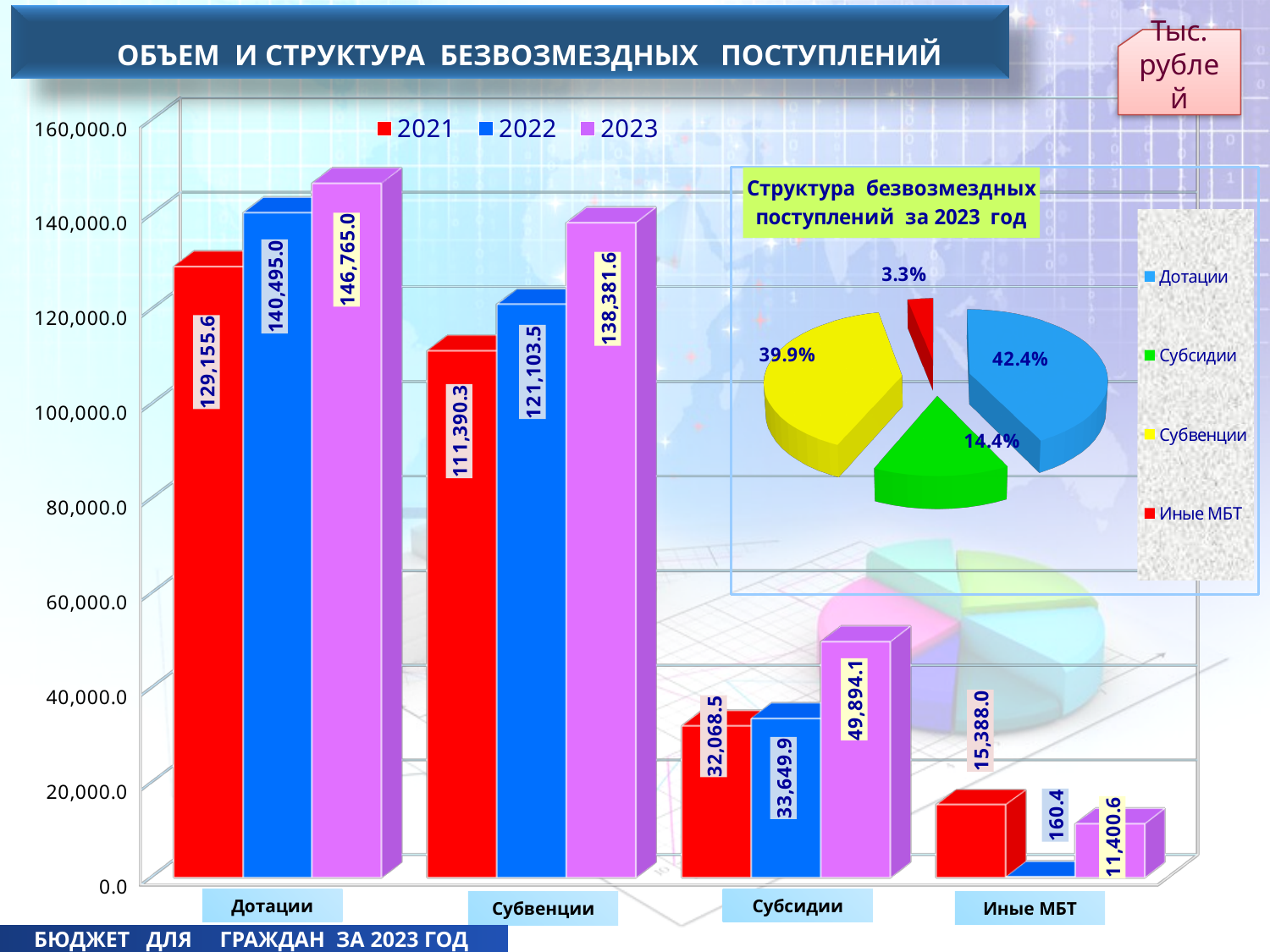
In the pie chart 'Структура безвозмездных поступлений за 2023 год', what share does Субвенции have? 39.9% In the bar chart, do the values for Дотации rise or fall from 2021 to 2023? rise In the bar chart, which category has the highest value in 2022? Дотации In the bar chart, what is the value for Иные МБТ in 2022? 160.4 In the bar chart, how many series does the legend list? 3 In the bar chart, what is the difference between the 2023 and 2022 values for Субсидии? 16,244.2 In the bar chart, which is larger for Субвенции: the 2022 value or the 2023 value? 2023 In the pie chart 'Структура безвозмездных поступлений за 2023 год', which slice is the smallest? Иные МБТ In the bar chart, what is the value for Субвенции in 2021? 111,390.3 In the bar chart, what is the value for Дотации in 2023? 146,765.0 In the bar chart, how many categories are shown on the x axis? 4 In the bar chart, which category has the lowest value in 2023? Иные МБТ